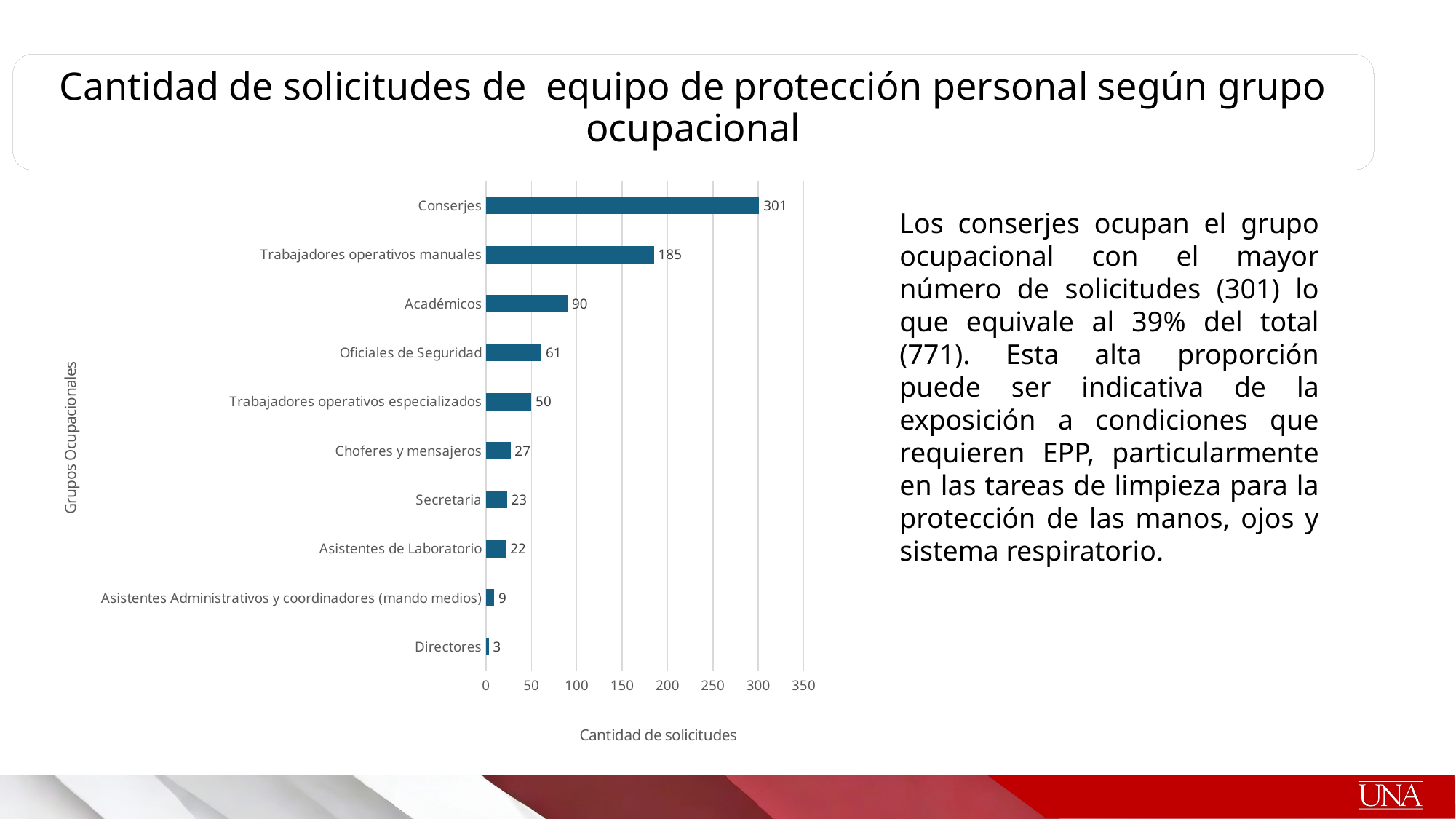
What is the value for Trabajadores operativos manuales? 185 How many occupational groups are shown in the chart? 10 What is the difference between the values for Conserjes and Trabajadores operativos manuales? 116 Which occupational group has the lowest number of requests? Directores Which occupational group has the highest number of requests? Conserjes How many requests for personal protective equipment did Conserjes make? 301 What kind of chart is shown on the slide? bar chart Is the value for Académicos greater or less than 100? less What is the difference between the values for Académicos and Oficiales de Seguridad? 29 Which has a larger value, Choferes y mensajeros or Secretaria? Choferes y mensajeros What is the value for Oficiales de Seguridad? 61 What is the label of the horizontal axis? Cantidad de solicitudes